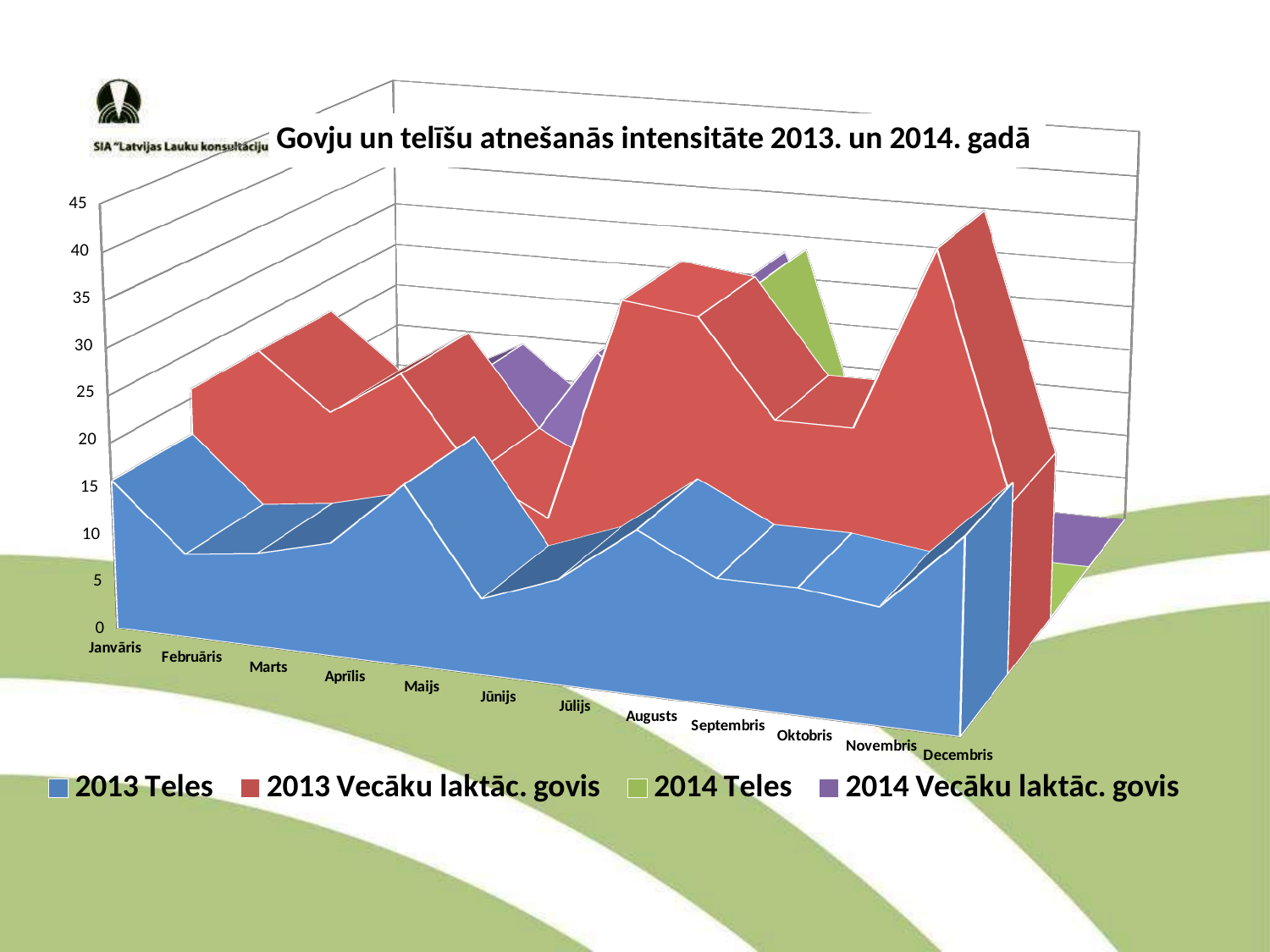
How many series does the legend list? 4 Is the value for 2013 Teles in Janvāris greater or less than 10? greater What is the highest value shown on the y axis? 45 What kind of chart is shown on the slide? area chart Which series is shown in blue? 2013 Teles What is the title of the chart? Govju un telīšu atnešanās intensitāte 2013. un 2014. gadā Does the value for 2013 Teles rise or fall from Novembris to Decembris? rise How many months are shown along the x axis? 12 Does the value for 2013 Teles rise or fall from Maijs to Jūnijs? fall Is the value for 2013 Teles in Jūnijs greater or less than 10? less Is the value for 2013 Teles in Decembris greater or less than 10? greater Which is larger for 2013 Teles: the value in Janvāris or the value in Jūnijs? Janvāris